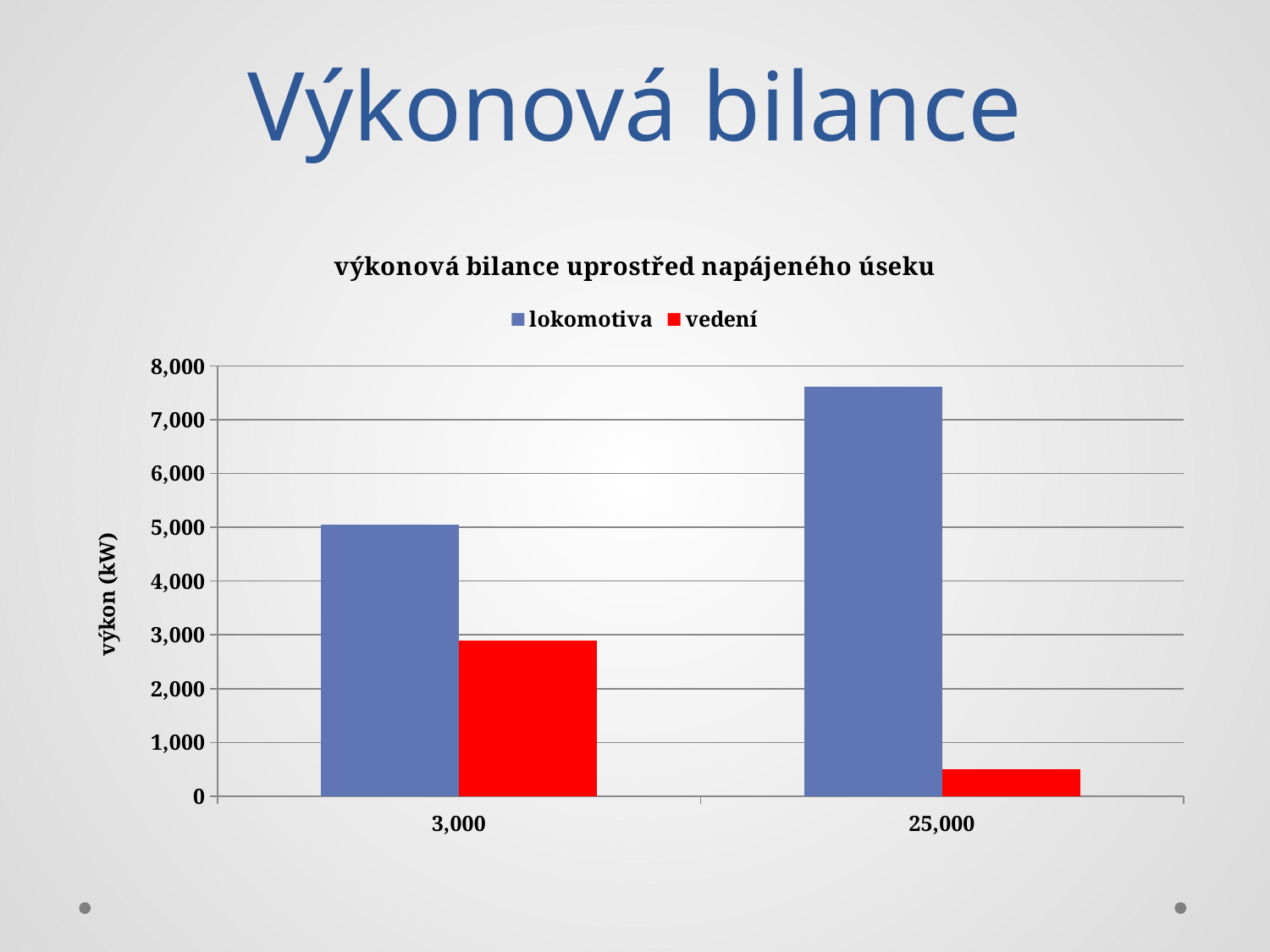
What kind of chart is shown on the slide? bar chart Is the value for vedení at 3,000 greater or less than 2,000? greater Is the value for lokomotiva at 25,000 greater or less than 7,000? greater Is the value for vedení at 25,000 greater or less than 1,000? less At 3,000, which is larger: lokomotiva or vedení? lokomotiva What is the title of the chart? výkonová bilance uprostřed napájeného úseku Which bar is the lowest in the chart? vedení at 25,000 Which bar is the highest in the chart? lokomotiva at 25,000 How many categories are shown on the x axis? 2 How many series does the legend list? 2 What is the label of the vertical axis? výkon (kW)